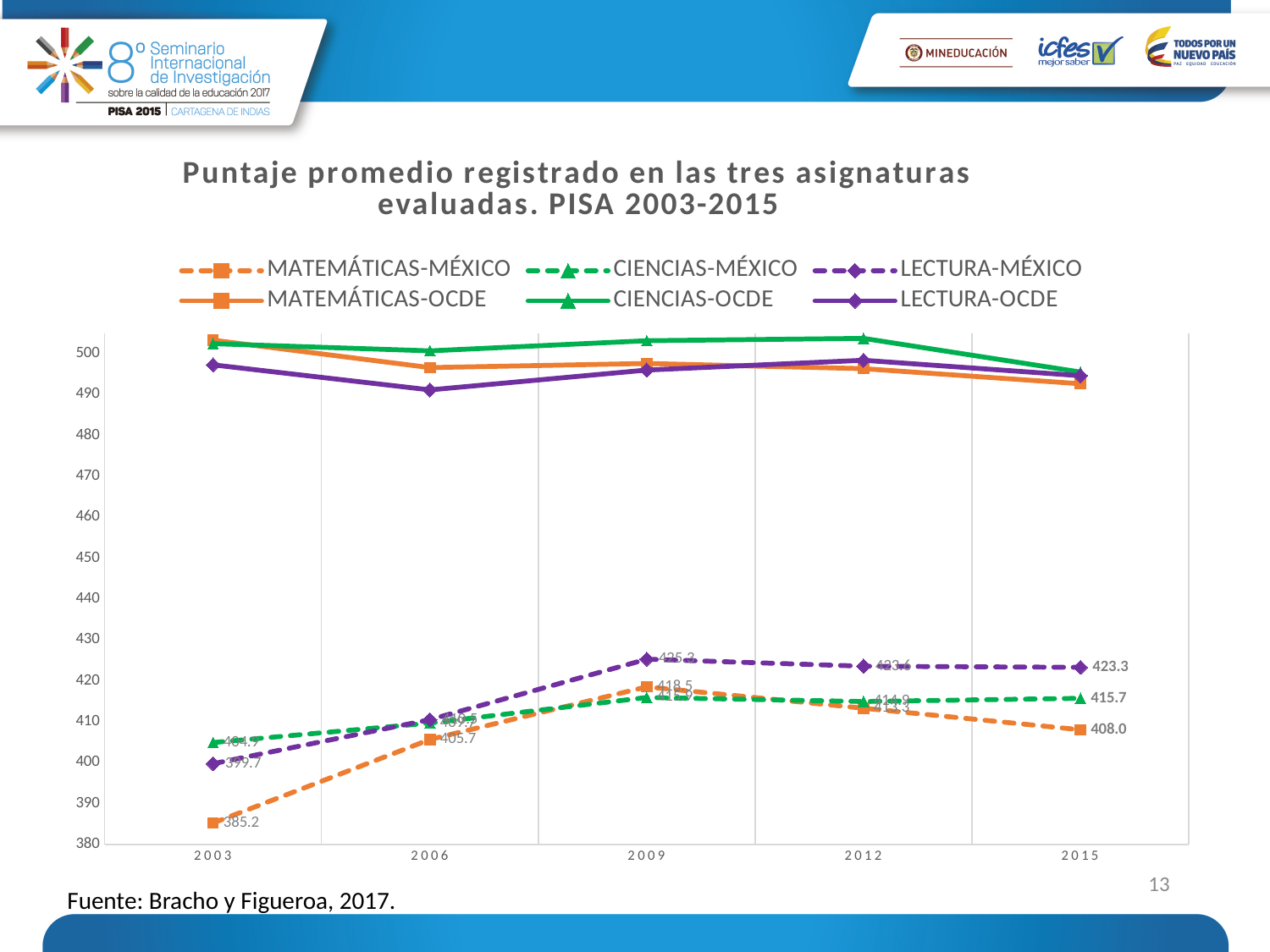
Does MATEMÁTICAS-MÉXICO rise or fall from 2003 to 2009? rise How many series does the legend list? 6 What kind of chart is shown on the slide? line chart What is the value for MATEMÁTICAS-MÉXICO in 2003? 385.2 What is the value for CIENCIAS-MÉXICO in 2015? 415.7 Which is larger in 2015, LECTURA-MÉXICO or CIENCIAS-MÉXICO? LECTURA-MÉXICO What is the value for LECTURA-MÉXICO in 2015? 423.3 What is the value for MATEMÁTICAS-MÉXICO in 2015? 408.0 By how much did MATEMÁTICAS-MÉXICO increase from 2003 to 2009? 33.3 What is the difference between LECTURA-MÉXICO and MATEMÁTICAS-MÉXICO in 2015? 15.3 How many years are shown on the x axis? 5 Is the value for CIENCIAS-OCDE in 2003 greater or less than 500? greater